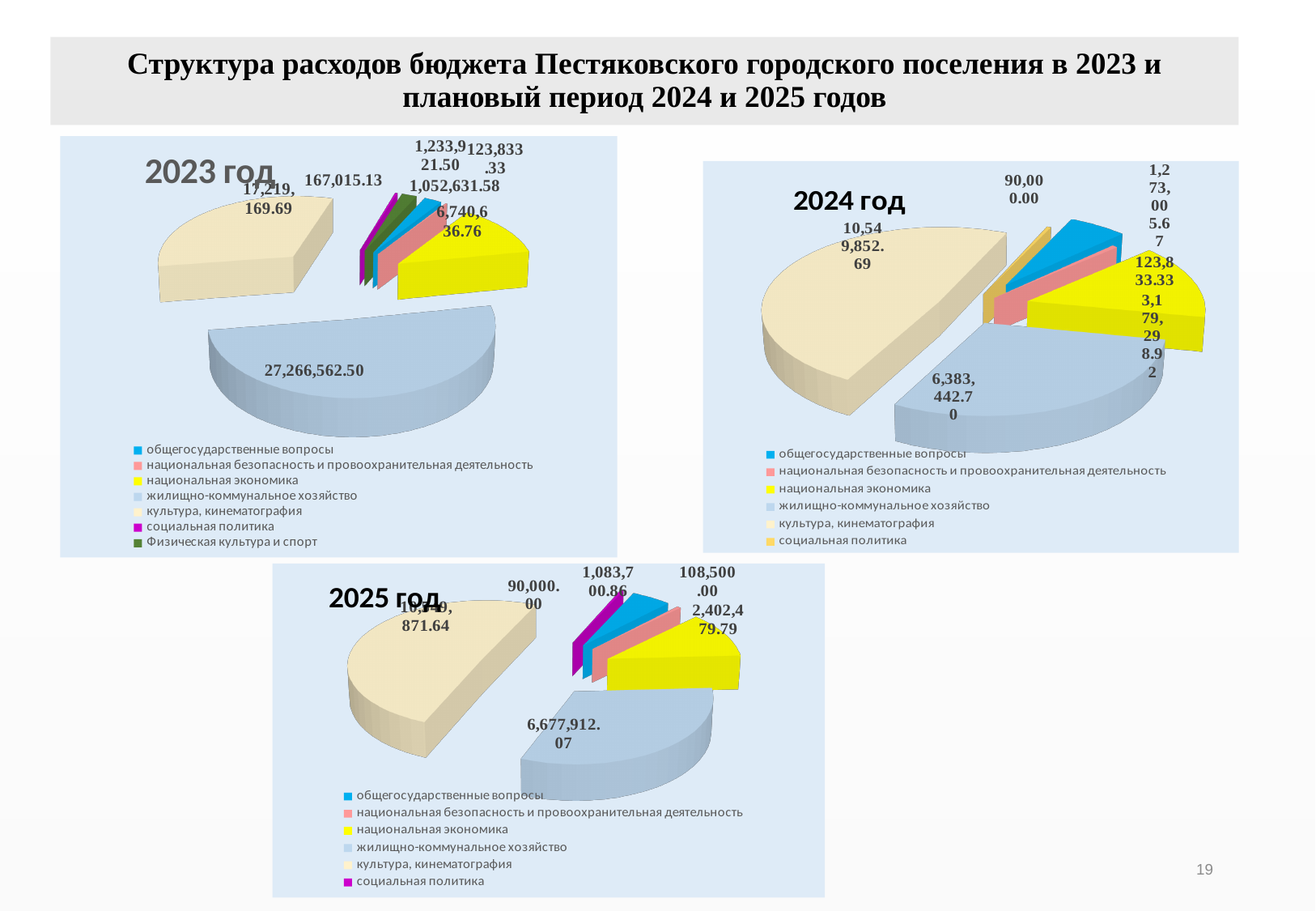
What is the difference between the жилищно-коммунальное хозяйство value in the 2025 год chart and in the 2024 год chart? 294,469.37 In the 2025 год chart, what is the value for жилищно-коммунальное хозяйство? 6,677,912.07 What type of chart is used for the 2023 год data? Pie chart In the 2024 год chart, which is larger: культура, кинематография or жилищно-коммунальное хозяйство? культура, кинематография How many categories does the legend of the 2023 год chart list? 7 In the 2024 год chart, what is the value for жилищно-коммунальное хозяйство? 6,383,442.70 In the 2023 год chart, which category has the largest slice? жилищно-коммунальное хозяйство In the 2024 год chart, what is the value for культура, кинематография? 10,549,852.69 In the 2025 год chart, what colour represents национальная экономика? Yellow In the 2023 год chart, what is the value for национальная экономика? 6,740,636.76 How many categories does the legend of the 2025 год chart list? 6 In the 2023 год chart, what is the value for жилищно-коммунальное хозяйство? 27,266,562.50